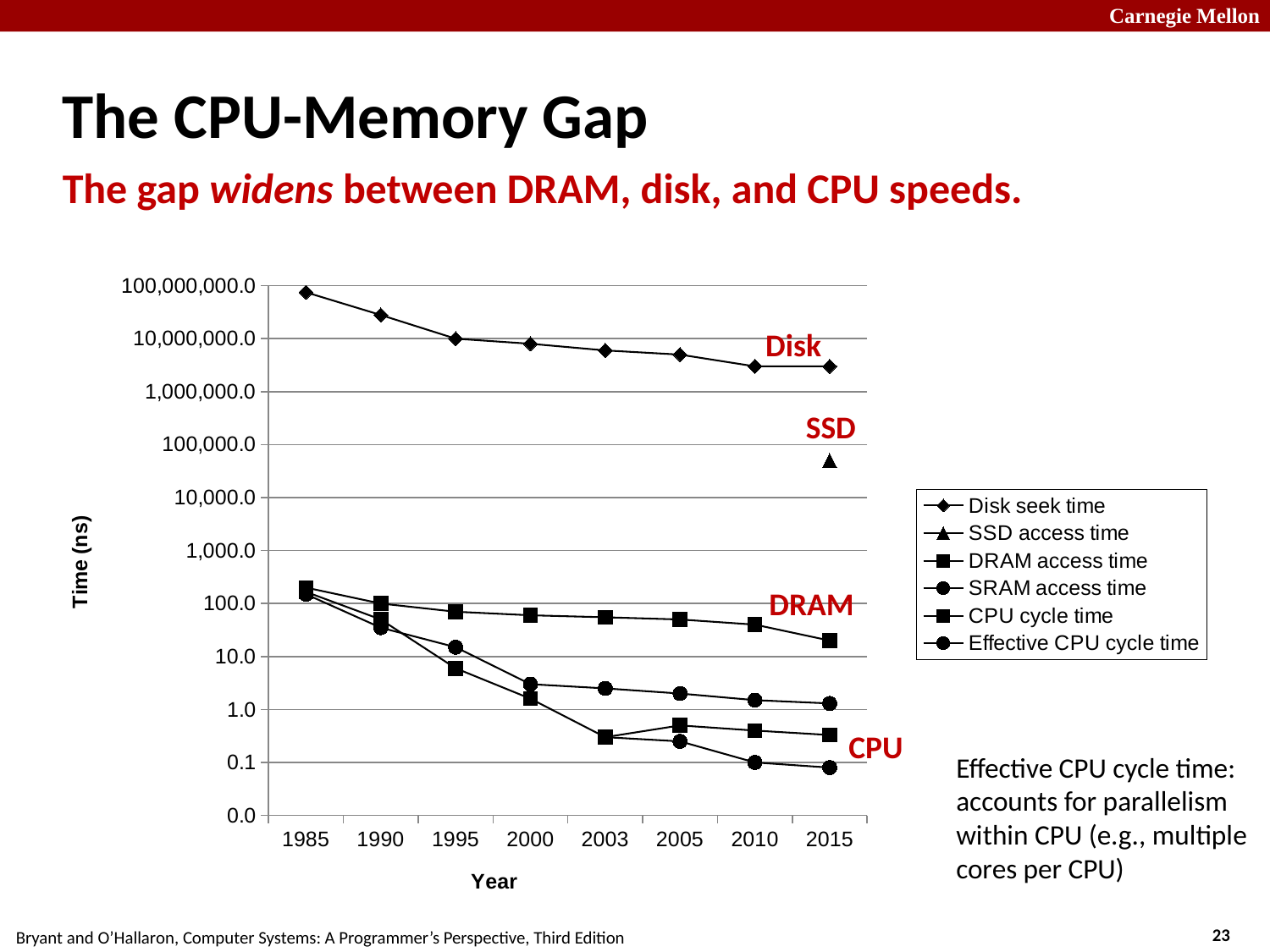
What kind of chart is shown on the slide? line chart Is the CPU cycle time in 2015 greater or less than 1.0? less How many years are marked along the x axis? 8 How many series does the legend list? 6 What is the label on the y axis? Time (ns) Is the Disk seek time in 2015 greater or less than 10,000,000.0? less Is the SSD access time in 2015 greater or less than 100,000.0? less Which is larger in 2015, the Disk seek time or the DRAM access time? Disk seek time Does the Disk seek time rise or fall from 1985 to 2015? fall Which series has the lowest value in 2015? Effective CPU cycle time Which series has the highest value in 2015? Disk seek time